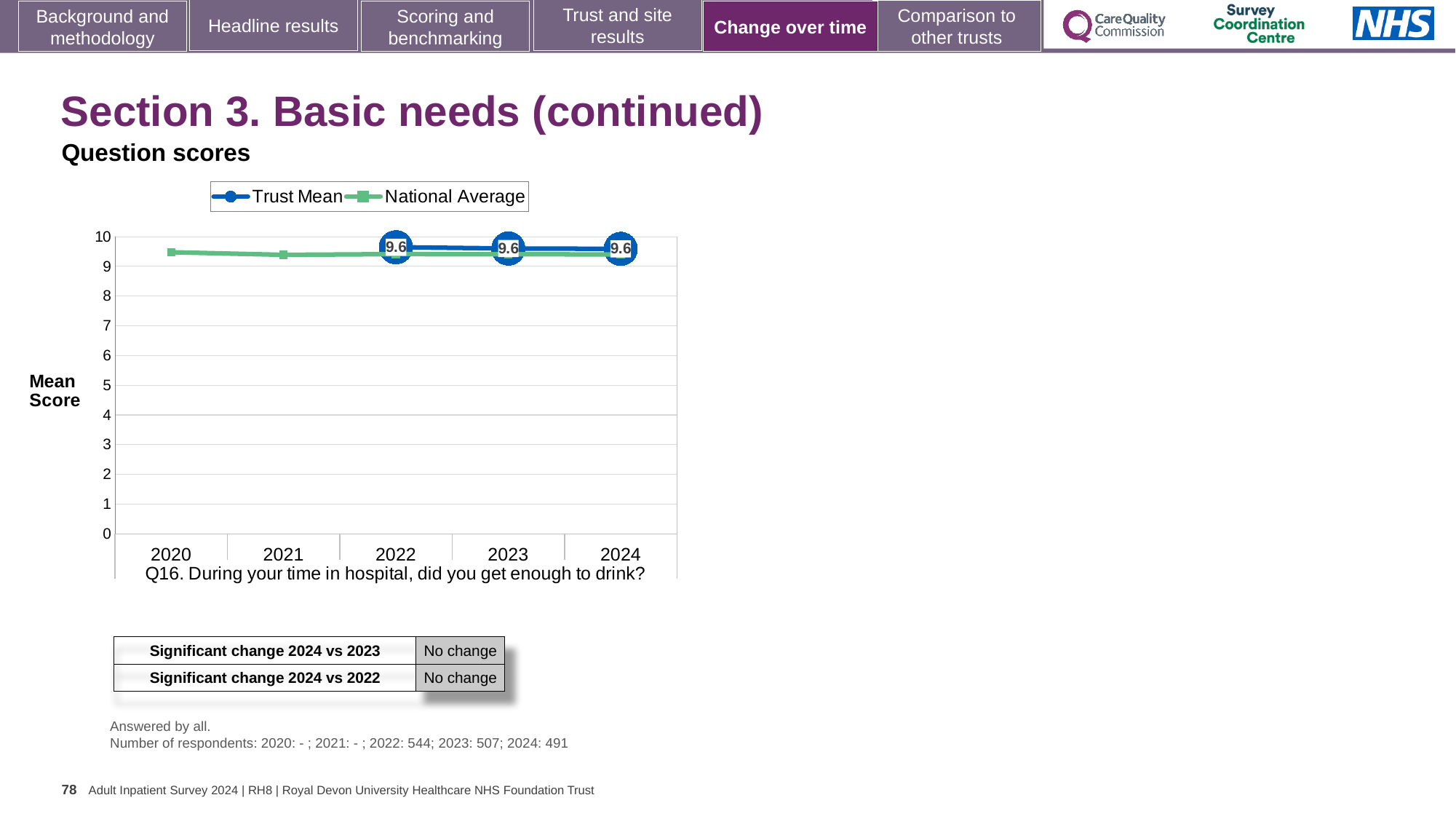
How many data points are plotted for the Trust Mean series? 3 Is the National Average score for 2020 greater or less than 9? greater How many series does the chart legend list? 2 How many years are shown on the x axis of the chart? 5 What is the Trust Mean score for 2022? 9.6 What is the Trust Mean score for 2024? 9.6 Does the Trust Mean score rise, fall or stay the same from 2022 to 2024? Stays the same Is the National Average score for 2021 greater or less than 8? greater What kind of chart is shown on the slide? Line chart What is the Trust Mean score for 2023? 9.6 What is the difference between the Trust Mean score in 2024 and in 2022? 0 What is the label on the y axis of the chart? Mean Score